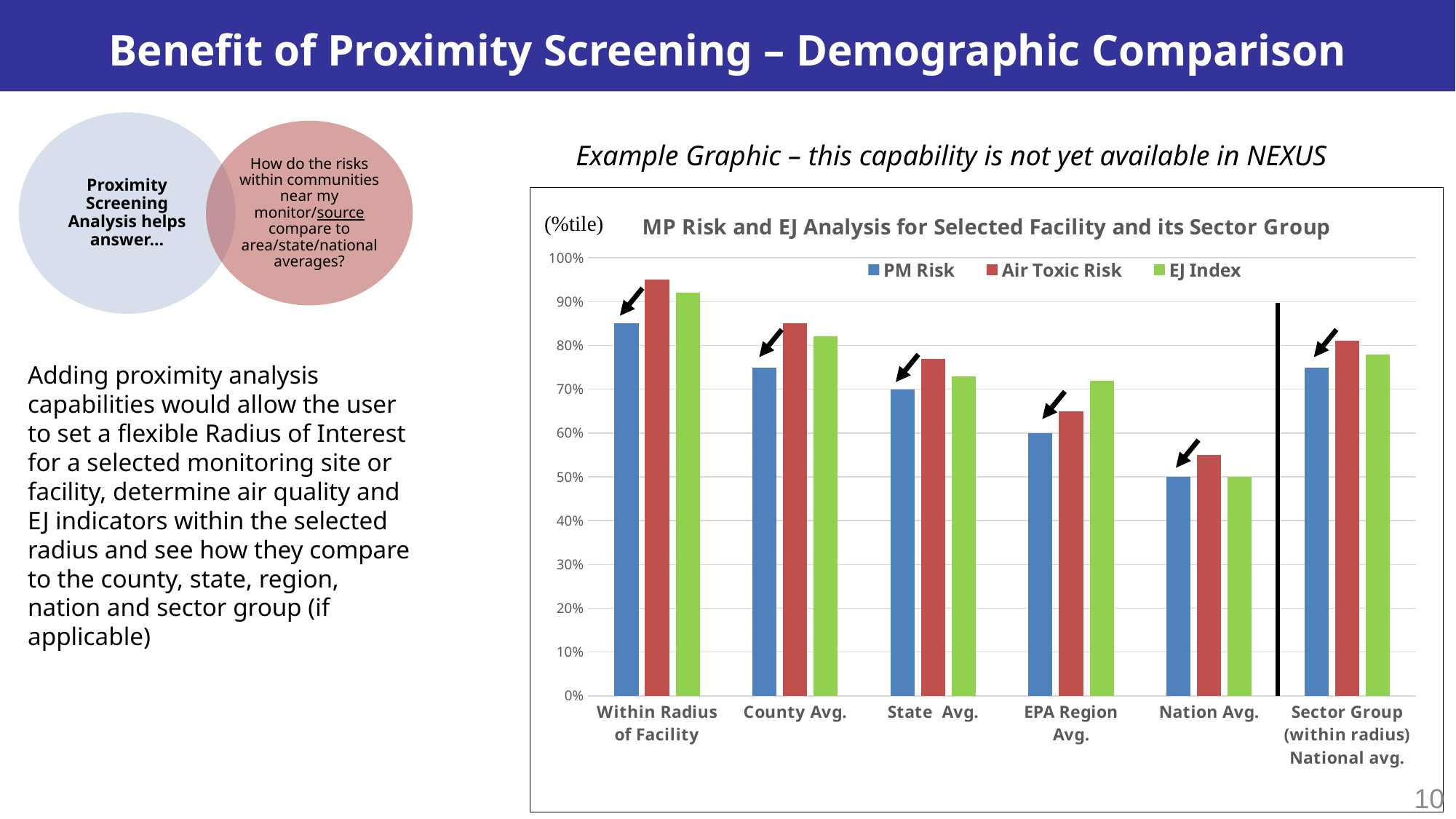
What kind of chart is shown on the slide? bar chart How many series does the legend of the chart list? 3 Is the PM Risk value for Sector Group (within radius) National avg. greater or less than 80%? less Which category has the lowest PM Risk value? Nation Avg. What is the title of the chart? MP Risk and EJ Analysis for Selected Facility and its Sector Group How many categories are shown along the x axis of the chart? 6 Is the Air Toxic Risk value for Within Radius of Facility greater or less than 90%? greater Do the PM Risk values rise or fall from Within Radius of Facility to Nation Avg.? fall Which category has the highest Air Toxic Risk value? Within Radius of Facility Which is larger for County Avg., the Air Toxic Risk value or the EJ Index value? Air Toxic Risk Which series is shown in green in the chart? EJ Index Is the EJ Index value for EPA Region Avg. greater or less than 70%? greater